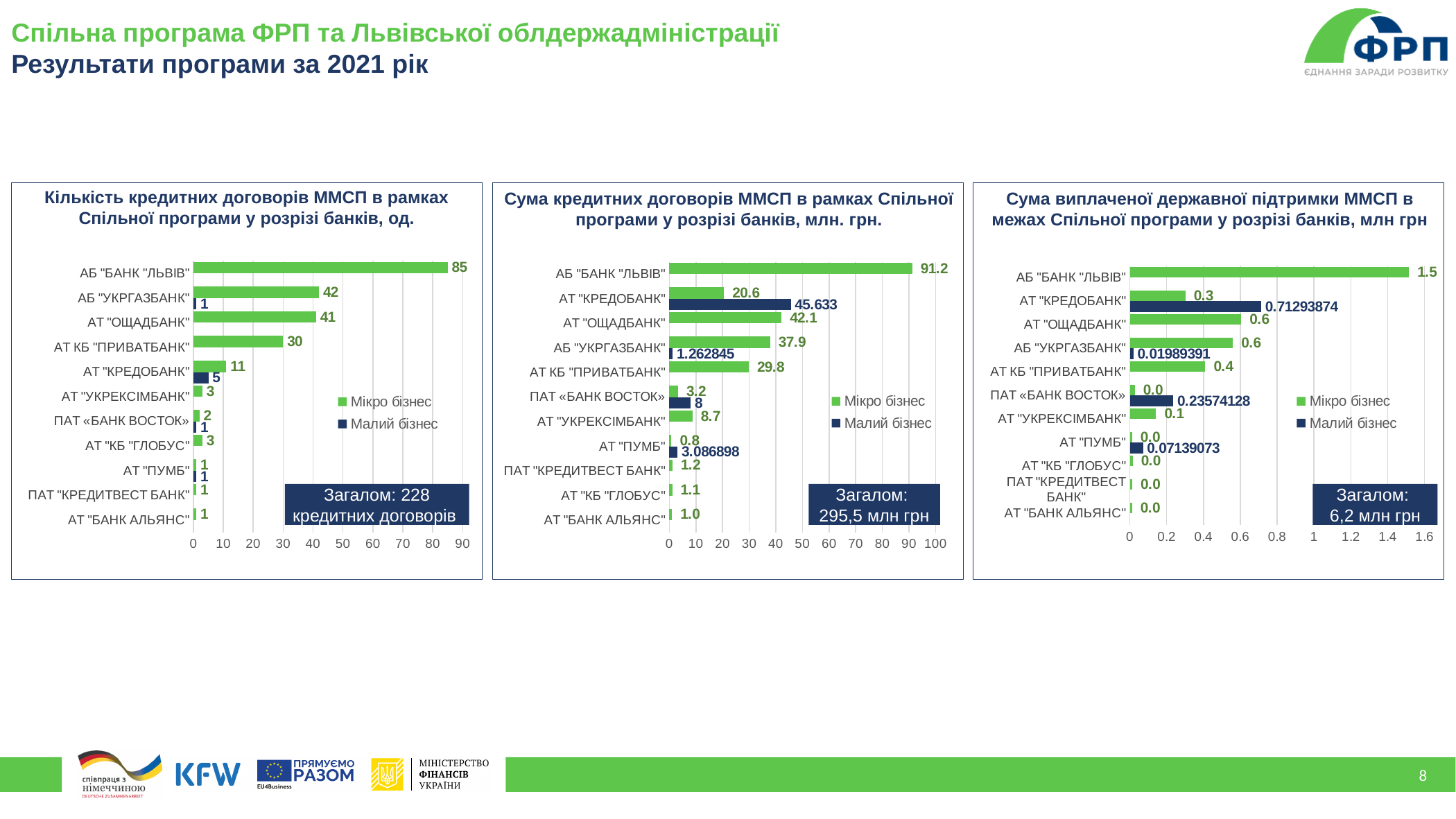
In the left chart (Кількість кредитних договорів ММСП), what is the difference between the Мікро бізнес values for АБ "УКРГАЗБАНК" and АТ КБ "ПРИВАТБАНК"? 12 In the left chart (Кількість кредитних договорів ММСП), which bank has the highest Мікро бізнес value? АБ "БАНК "ЛЬВІВ" In the middle chart (Сума кредитних договорів ММСП), which is larger: the Мікро бізнес value for АБ "УКРГАЗБАНК" or for АТ КБ "ПРИВАТБАНК"? АБ "УКРГАЗБАНК" In the right chart (Сума виплаченої державної підтримки ММСП), what is the Малий бізнес value for ПАТ «БАНК ВОСТОК»? 0.23574128 In the left chart (Кількість кредитних договорів ММСП), what is the Мікро бізнес value for АБ "БАНК "ЛЬВІВ"? 85 In the middle chart (Сума кредитних договорів ММСП), what total is stated in the box on the chart? 295,5 млн грн In the middle chart (Сума кредитних договорів ММСП), what is the Малий бізнес value for АТ "КРЕДОБАНК"? 45.633 How many series does the legend list in the right chart (Сума виплаченої державної підтримки ММСП)? 2 In the left chart (Кількість кредитних договорів ММСП), what is the Малий бізнес value for АТ "КРЕДОБАНК"? 5 In the right chart (Сума виплаченої державної підтримки ММСП), what is the Мікро бізнес value for АБ "БАНК "ЛЬВІВ"? 1.5 In the middle chart (Сума кредитних договорів ММСП), what is the Мікро бізнес value for АТ "ОЩАДБАНК"? 42.1 What type of chart is the left chart (Кількість кредитних договорів ММСП)? Bar chart